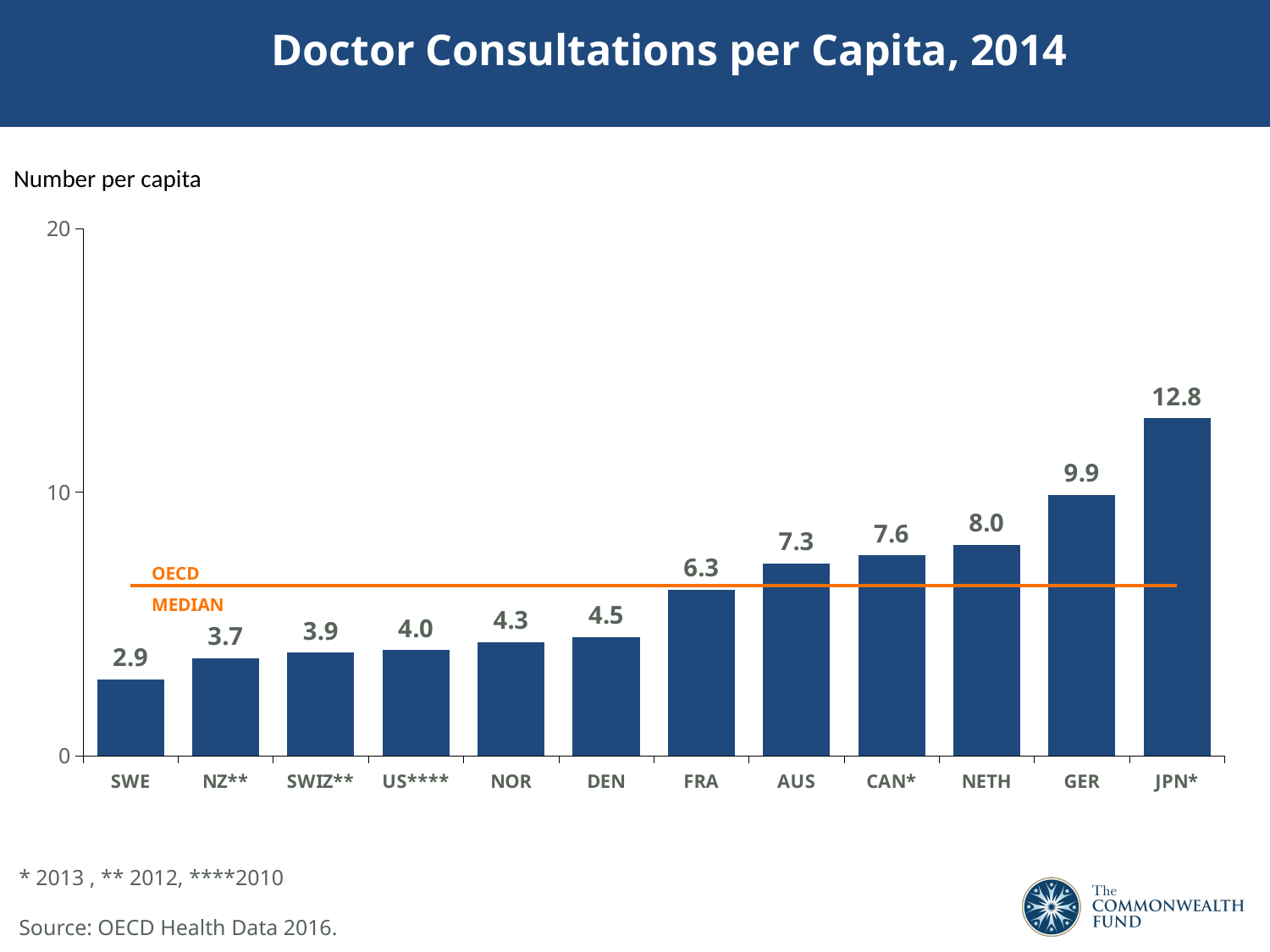
What is the value shown for CAN*? 7.6 What kind of chart is shown on the slide? Bar chart What does the orange horizontal line on the chart represent? OECD median What is the number of doctor consultations per capita for GER? 9.9 How many countries are shown on the chart? 12 Which country has the lowest number of doctor consultations per capita? SWE Which country has the highest number of doctor consultations per capita? JPN* What is the difference between the values for JPN* and SWE? 9.9 Is the value for GER greater or less than 10? less What is the difference between the values for NETH and FRA? 1.7 Which has a higher value, AUS or DEN? AUS What is the value shown for US****? 4.0